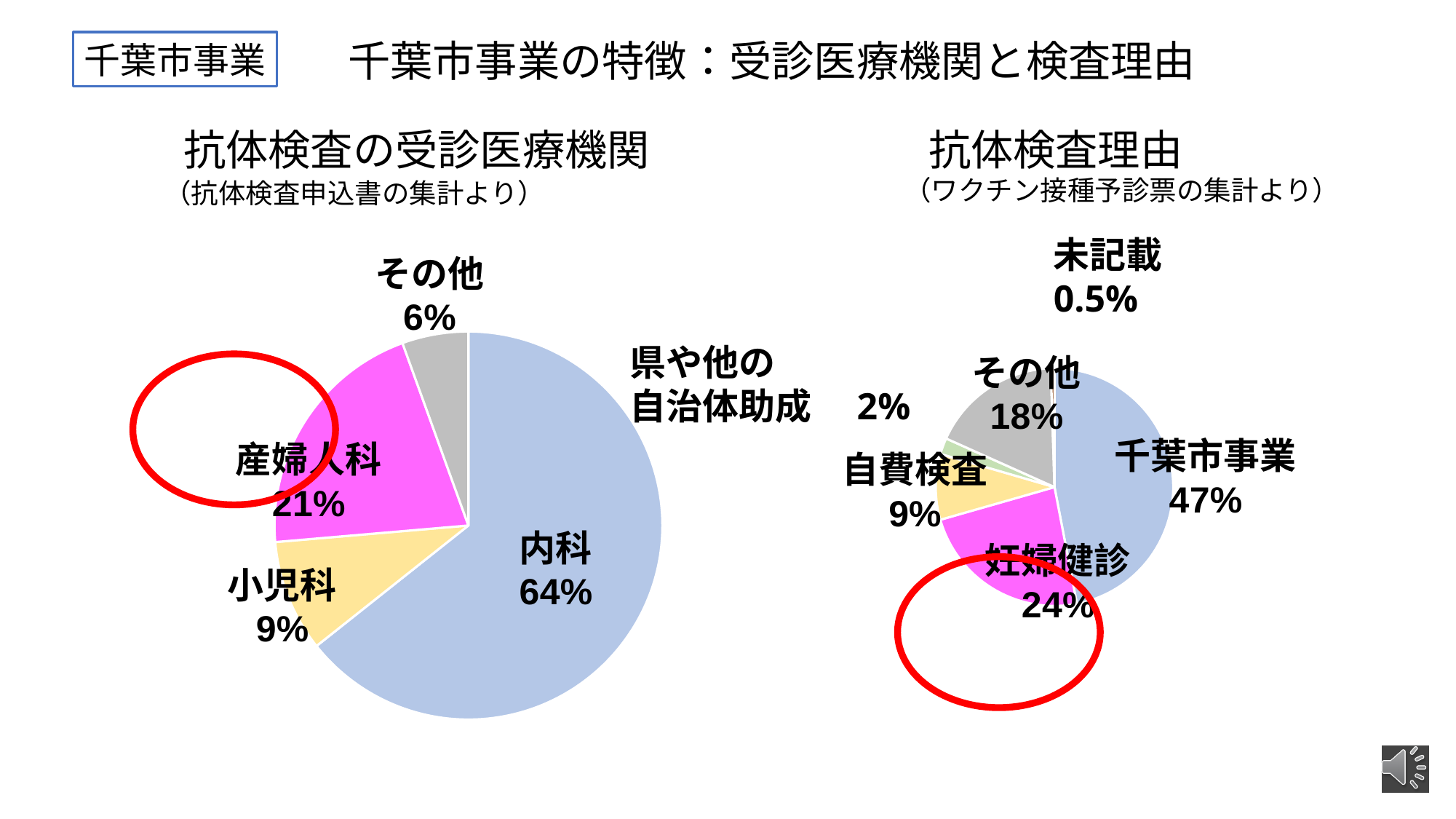
In the right chart (抗体検査理由), what share is 妊婦健診? 24% In the right chart (抗体検査理由), which is larger, その他 or 自費検査? その他 In the left chart (抗体検査の受診医療機関), what share is 内科? 64% In the right chart (抗体検査理由), which category has the largest share? 千葉市事業 What kind of chart is used on the left side of the slide? Pie chart In the left chart (抗体検査の受診医療機関), which category has the smallest share? その他 In the left chart (抗体検査の受診医療機関), how many categories are shown? 4 In the left chart (抗体検査の受診医療機関), what is the difference between 産婦人科 and 小児科? 12% In the right chart (抗体検査理由), how many categories are shown? 6 In the right chart (抗体検査理由), what is the difference between 千葉市事業 and 妊婦健診? 23% In the right chart (抗体検査理由), what share is 未記載? 0.5% In the left chart (抗体検査の受診医療機関), what share is 産婦人科? 21%